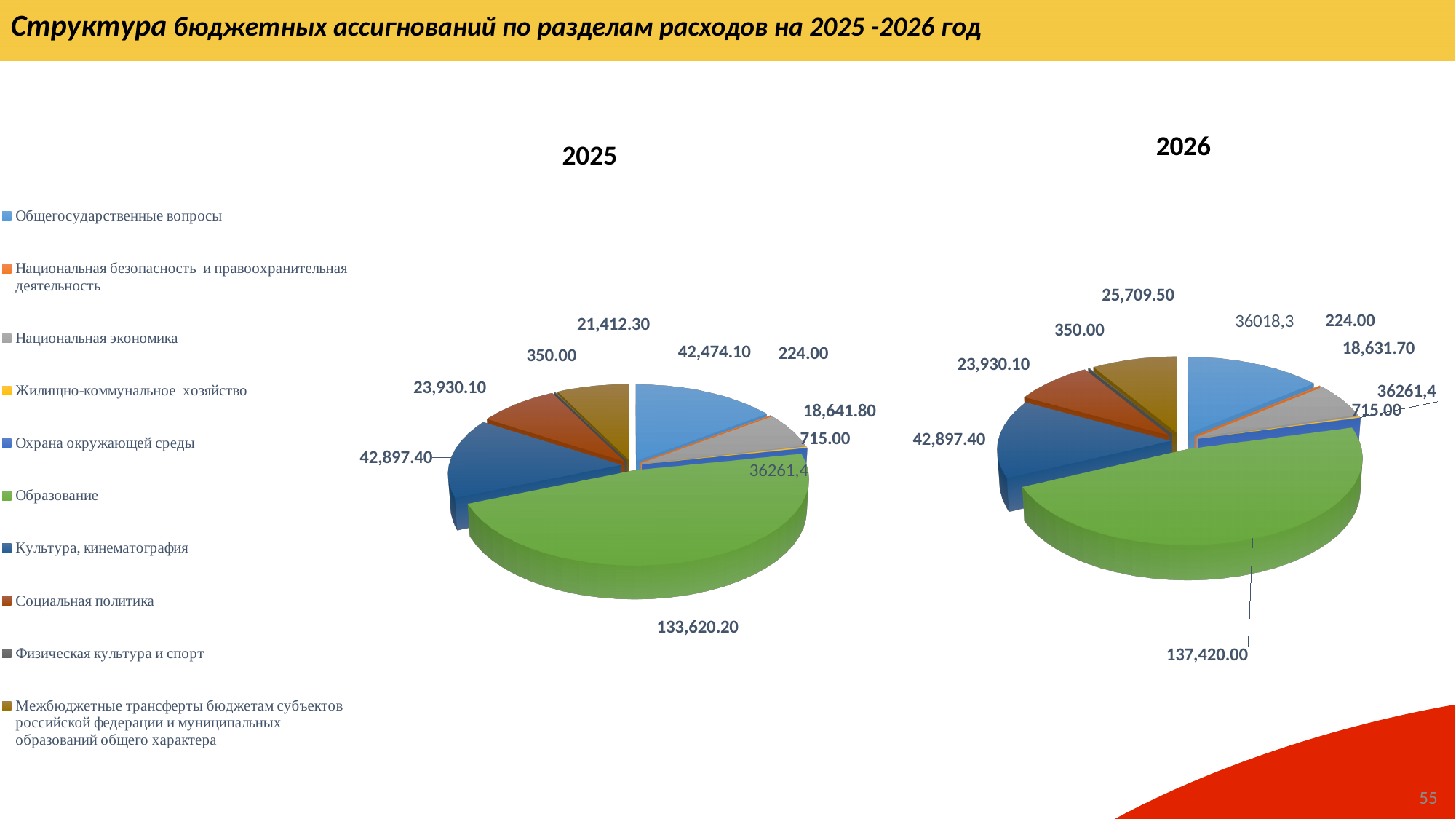
How many charts are shown on the slide? 2 In the 2026 chart, what is the value for Физическая культура и спорт? 350.00 In the 2026 chart, what is the value for Образование? 137,420.00 How many categories does the legend list? 10 In the 2025 chart, what is the value for Культура, кинематография? 42,897.40 In the 2025 chart, which category has the largest slice? Образование In the 2025 chart, what is the value for Образование? 133,620.20 In the 2026 chart, what is the value for Социальная политика? 23,930.10 In the 2025 chart, which is larger: Образование or Культура, кинематография? Образование What kind of chart is used for the 2025 data on the slide? Pie chart In the 2025 chart, what is the value for Национальная экономика? 18,641.80 What is the difference between the Образование value in the 2026 chart and in the 2025 chart? 3,799.80